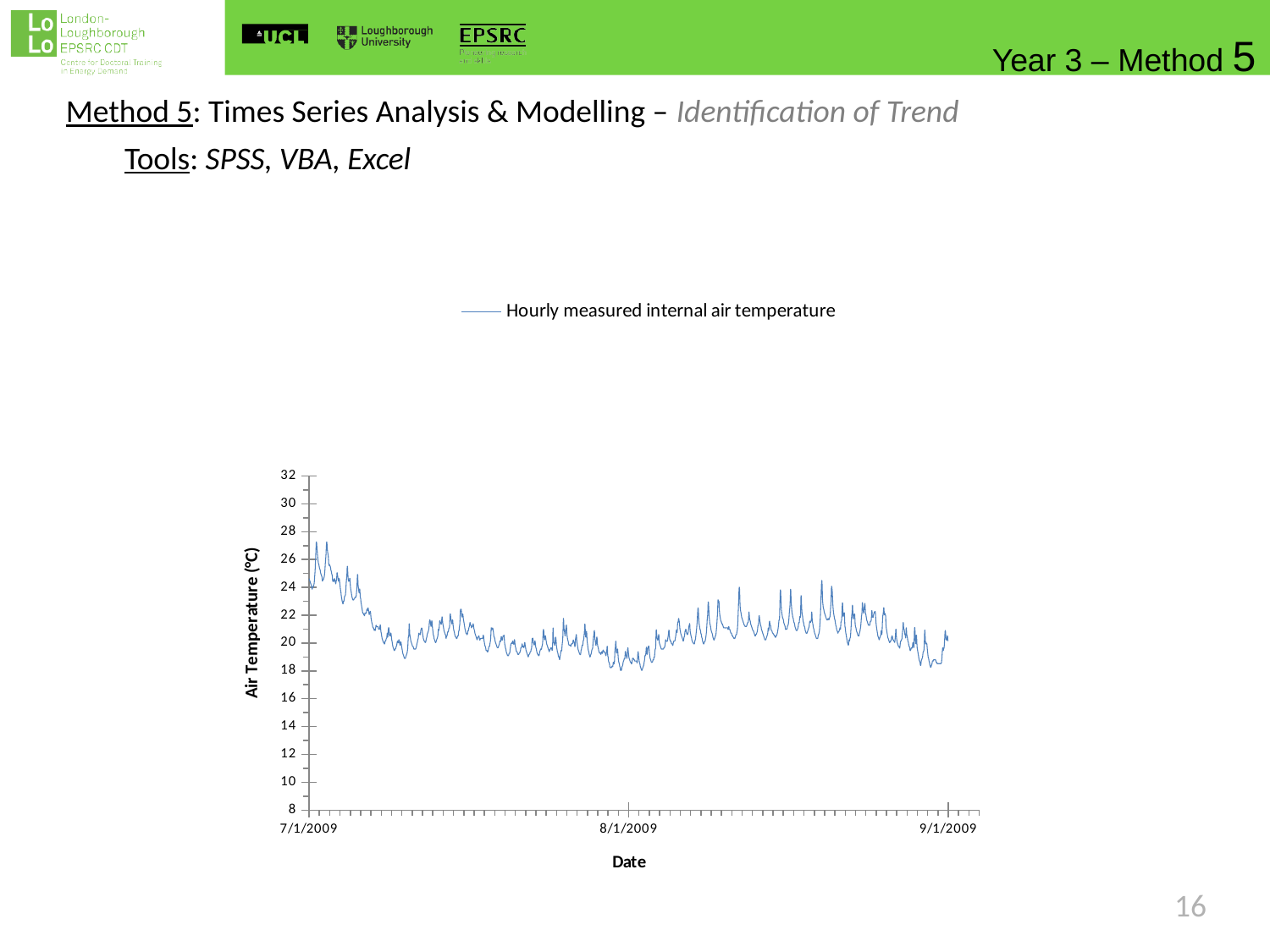
Is the lowest air temperature plotted on the chart greater or less than 16? greater What kind of chart is shown on the slide? line chart Do the plotted air temperatures generally rise or fall between 7/1/2009 and 8/1/2009? fall Is the highest air temperature plotted on the chart greater or less than 26? greater What is the title of the vertical axis of the chart? Air Temperature (°C) What is the name of the series shown in the chart legend? Hourly measured internal air temperature Is the air temperature plotted at the start of the series on 7/1/2009 greater or less than 22? greater Which is larger: the air temperature at the start of the series on 7/1/2009 or the air temperature around 8/1/2009? 7/1/2009 How many date labels are shown on the horizontal axis of the chart? 3 How many series does the chart legend list? 1